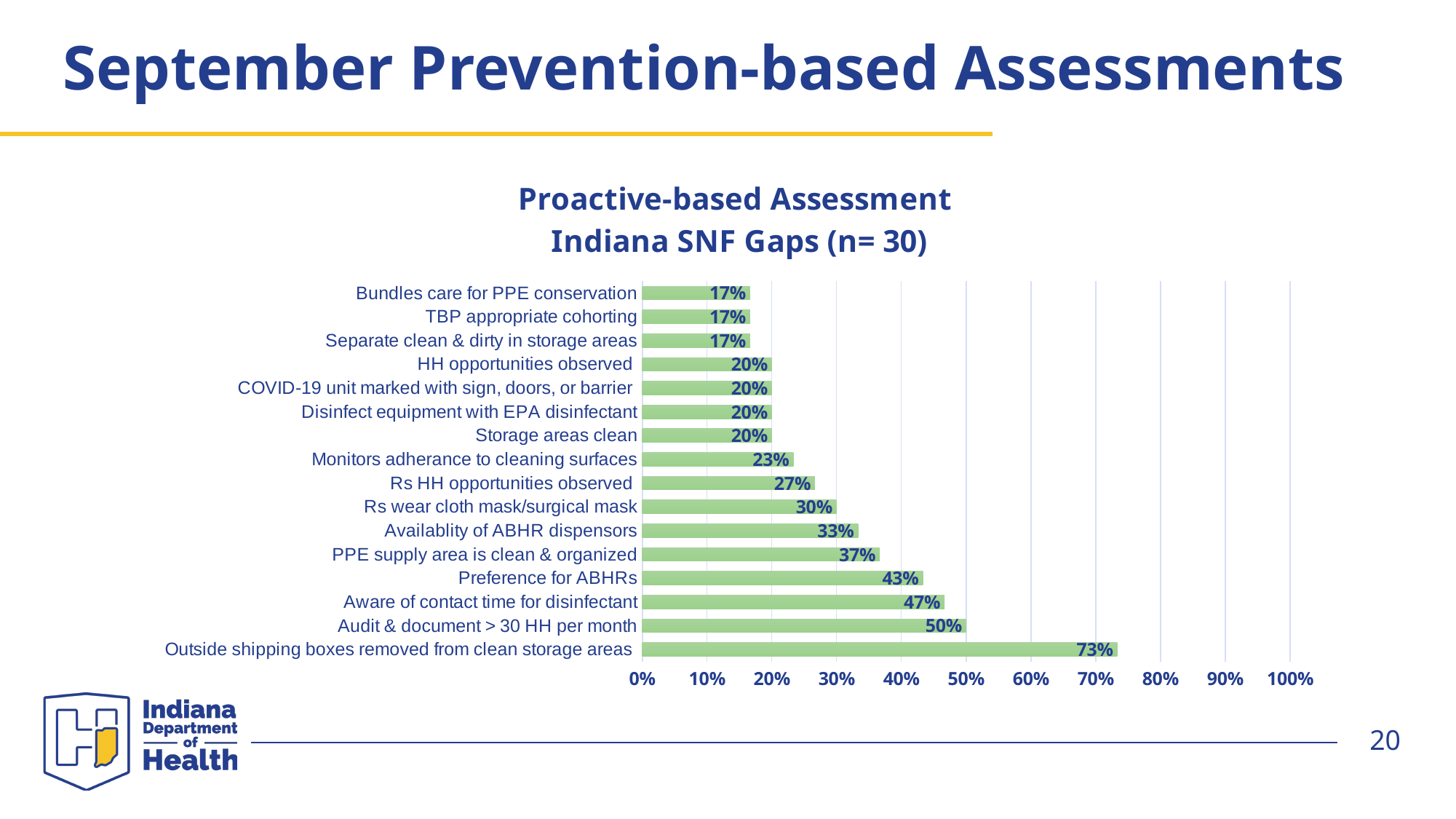
What is the sample size (n) stated in the chart title? 30 How many categories are shown in the chart? 16 What is the value for 'Rs wear cloth mask/surgical mask'? 30% Which category has the highest value? Outside shipping boxes removed from clean storage areas What is the value for 'Preference for ABHRs'? 43% Which is larger: 'Availablity of ABHR dispensors' or 'Monitors adherance to cleaning surfaces'? Availablity of ABHR dispensors What kind of chart is shown on the slide? bar chart What is the value for 'Audit & document > 30 HH per month'? 50% Is the value for 'Rs HH opportunities observed' greater or less than 30%? less What is the lowest value shown in the chart? 17% What is the difference between 'Outside shipping boxes removed from clean storage areas' and 'Audit & document > 30 HH per month'? 23% What is the difference between 'Aware of contact time for disinfectant' and 'PPE supply area is clean & organized'? 10%